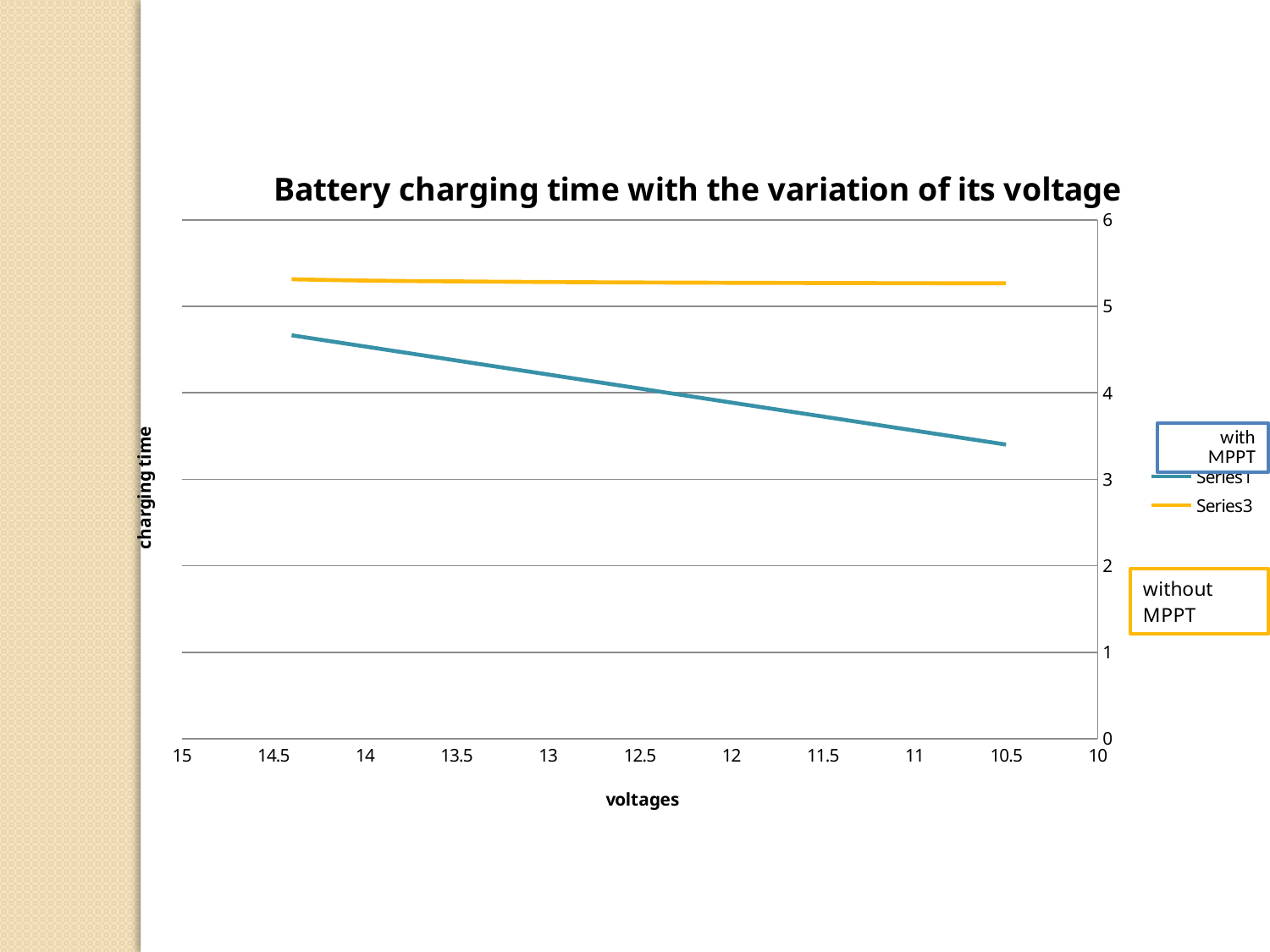
What is the title of the chart? Battery charging time with the variation of its voltage What is the label of the vertical axis? charging time Is the value of the Series1 (with MPPT) line at 10.5 volts greater or less than 4? less Does the Series1 (with MPPT) line rise or fall as the voltage decreases from 14.5 to 10.5 along the x axis? fall What kind of chart is shown on the slide? line chart Which series shows the lower charging time across the whole voltage range? Series1 Is the value of the Series3 (without MPPT) line at 10.5 volts greater or less than 5? greater How many series does the legend list? 2 Which series has the higher charging time at 12 volts, Series1 or Series3? Series3 Is the value of the Series1 (with MPPT) line at 14.5 volts greater or less than 4? greater